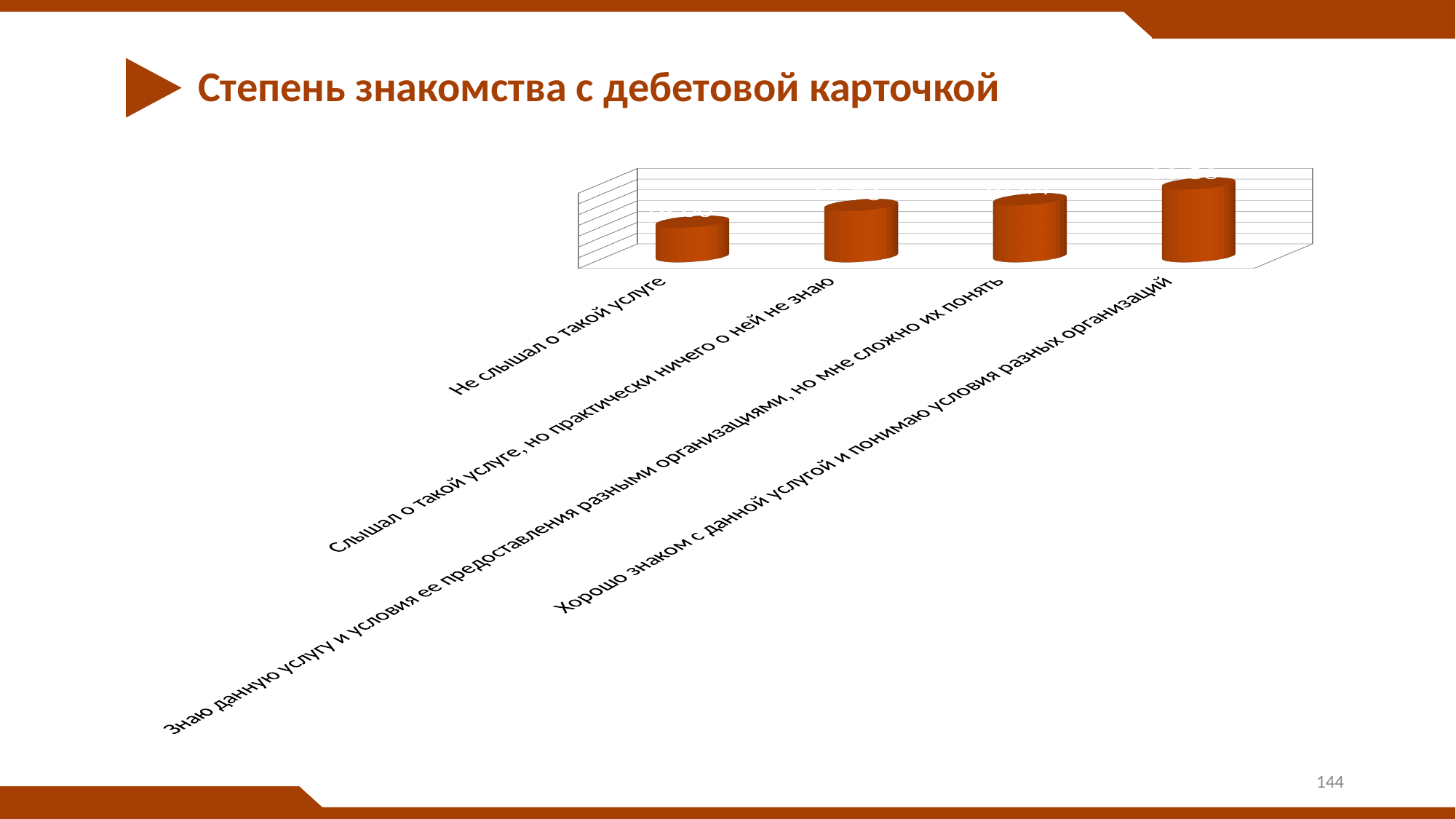
Which category has the lowest bar? Не слышал о такой услуге Do the bar values rise or fall from left to right along the x axis? rise What colour are the bars in the chart? orange-brown Which is larger: the bar for "Не слышал о такой услуге" or the bar for "Слышал о такой услуге, но практически ничего о ней не знаю"? Слышал о такой услуге, но практически ничего о ней не знаю Which category has the highest bar? Хорошо знаком с данной услугой и понимаю условия разных организаций Which is larger: the bar for "Не слышал о такой услуге" or the bar for "Хорошо знаком с данной услугой и понимаю условия разных организаций"? Хорошо знаком с данной услугой и понимаю условия разных организаций What is the title of the slide containing the chart? Степень знакомства с дебетовой карточкой Which is larger: the bar for "Знаю данную услугу и условия ее предоставления разными организациями, но мне сложно их понять" or the bar for "Хорошо знаком с данной услугой и понимаю условия разных организаций"? Хорошо знаком с данной услугой и понимаю условия разных организаций What kind of chart is shown on the slide? bar chart How many categories are plotted in the chart? 4